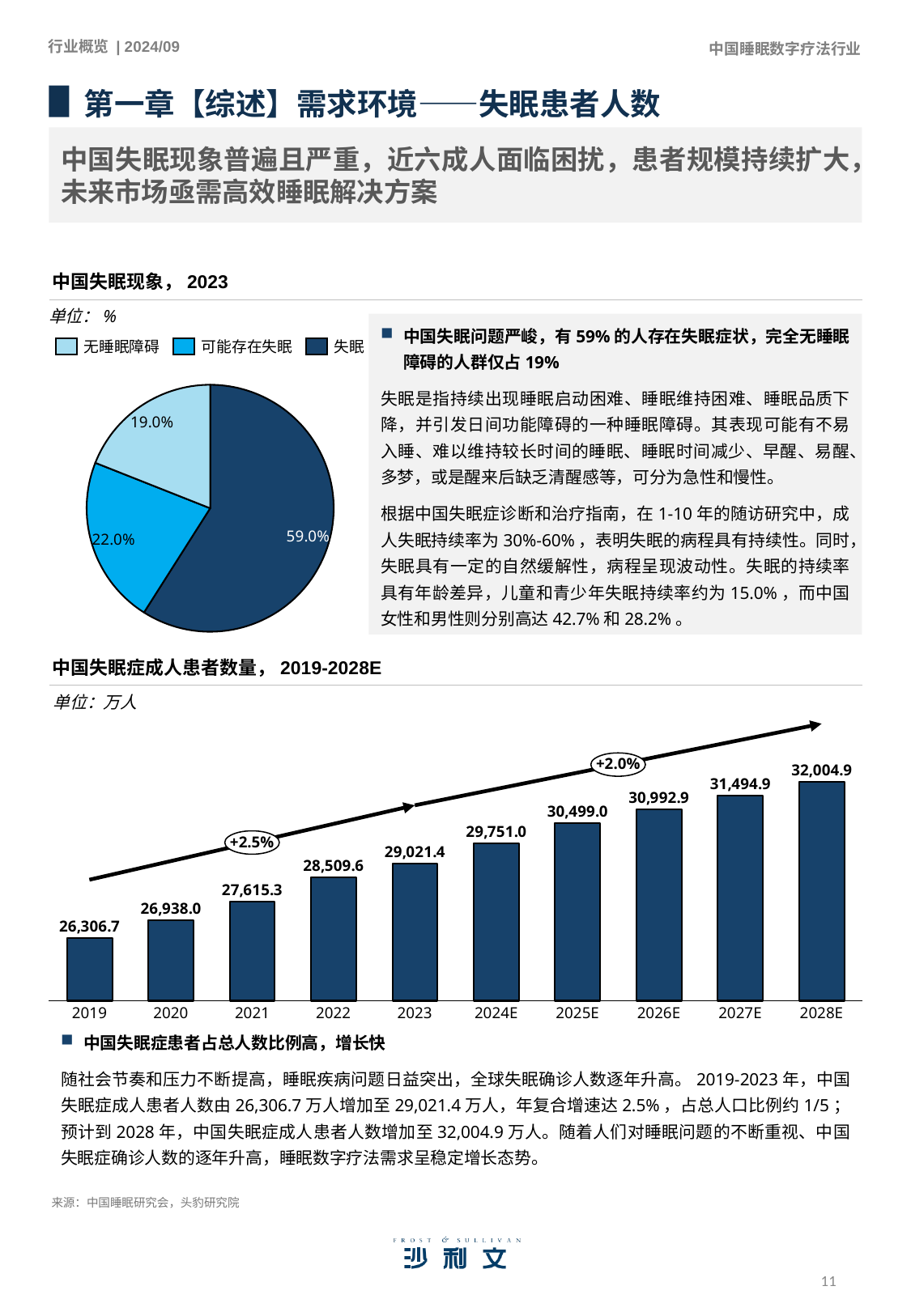
In the bar chart 中国失眠症成人患者数量, 2019-2028E, what is the difference between the 2028E and 2019 values? 5,698.2 In the bar chart 中国失眠症成人患者数量, 2019-2028E, how many years are shown on the x axis? 10 In the pie chart 中国失眠现象, 2023, what is the value for 无睡眠障碍? 19.0% In the bar chart 中国失眠症成人患者数量, 2019-2028E, which year has the lowest value? 2019 In the bar chart 中国失眠症成人患者数量, 2019-2028E, what is the value for 2023? 29,021.4 In the pie chart 中国失眠现象, 2023, what is the difference between the 可能存在失眠 and 无睡眠障碍 shares? 3.0% What type of chart is 中国失眠症成人患者数量, 2019-2028E? bar chart In the bar chart 中国失眠症成人患者数量, 2019-2028E, which year has the highest value? 2028E In the pie chart 中国失眠现象, 2023, how many categories does the legend list? 3 In the pie chart 中国失眠现象, 2023, what share is labelled for 失眠? 59.0% In the bar chart 中国失眠症成人患者数量, 2019-2028E, do the values rise or fall from 2019 to 2028E? rise In the pie chart 中国失眠现象, 2023, which category has the smallest slice? 无睡眠障碍